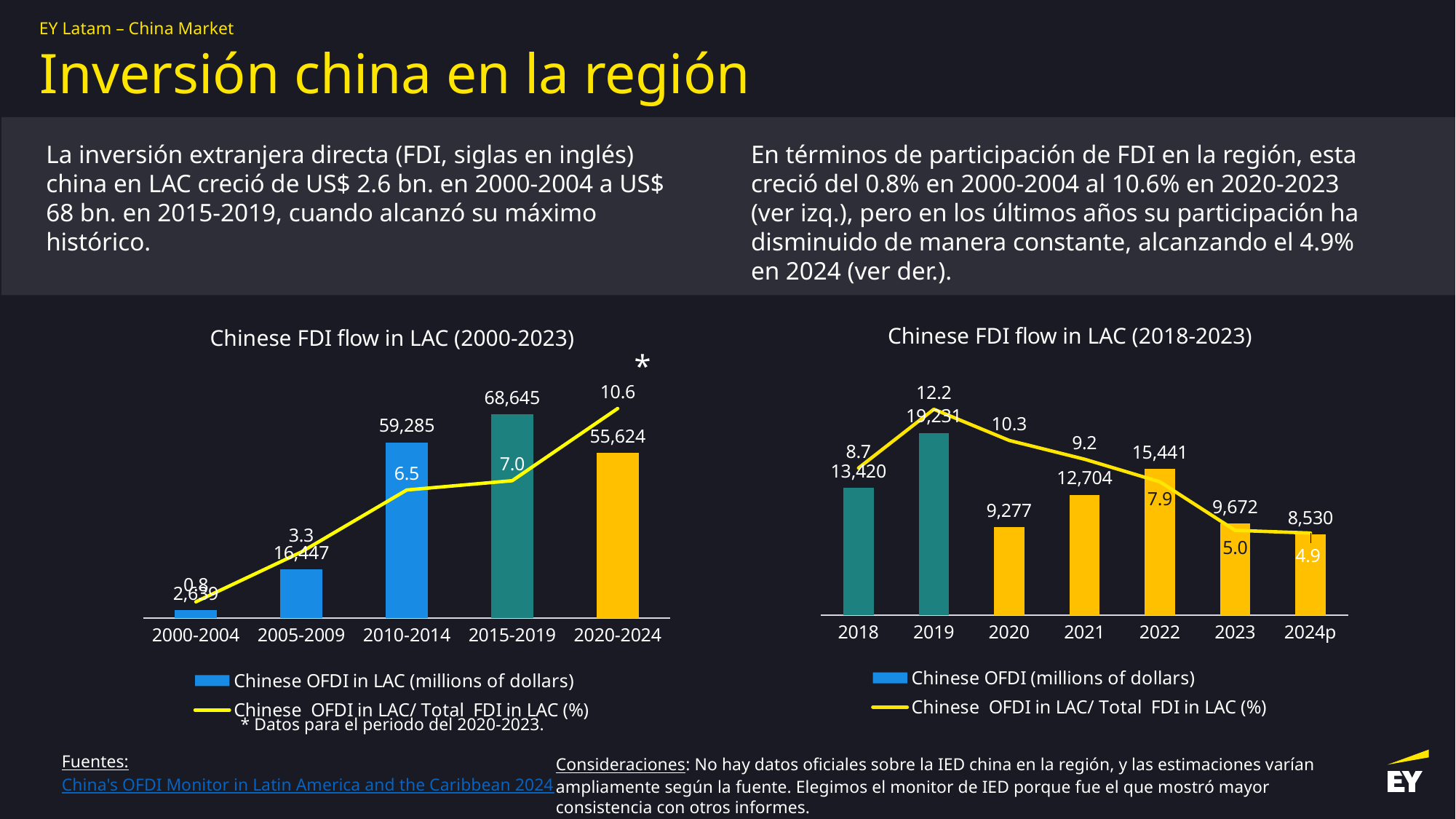
In the chart titled "Chinese FDI flow in LAC (2018-2023)", what is the Chinese OFDI (millions of dollars) for 2022? 15,441 In the chart titled "Chinese FDI flow in LAC (2018-2023)", what is the Chinese OFDI in LAC / Total FDI in LAC (%) value for 2024p? 4.9 In the chart titled "Chinese FDI flow in LAC (2018-2023)", what is the difference in Chinese OFDI (millions of dollars) between 2019 and 2020? 9,954 In the chart titled "Chinese FDI flow in LAC (2018-2023)", which year has the highest Chinese OFDI (millions of dollars)? 2019 In the chart titled "Chinese FDI flow in LAC (2000-2023)", how many periods are shown on the x axis? 5 In the chart titled "Chinese FDI flow in LAC (2000-2023)", does the Chinese OFDI in LAC / Total FDI in LAC (%) line rise or fall from 2000-2004 to 2020-2024? rise In the chart titled "Chinese FDI flow in LAC (2000-2023)", what is the Chinese OFDI in LAC / Total FDI in LAC (%) value for 2020-2024? 10.6 In the chart titled "Chinese FDI flow in LAC (2000-2023)", which period has the lowest Chinese OFDI in LAC (millions of dollars)? 2000-2004 In the chart titled "Chinese FDI flow in LAC (2018-2023)", which is larger, the Chinese OFDI (millions of dollars) for 2018 or for 2021? 2018 In the chart titled "Chinese FDI flow in LAC (2000-2023)", what is the difference in Chinese OFDI in LAC (millions of dollars) between 2015-2019 and 2020-2024? 13,021 In the chart titled "Chinese FDI flow in LAC (2018-2023)", how many series does the legend list? 2 In the chart titled "Chinese FDI flow in LAC (2000-2023)", what is the Chinese OFDI in LAC (millions of dollars) for 2015-2019? 68,645